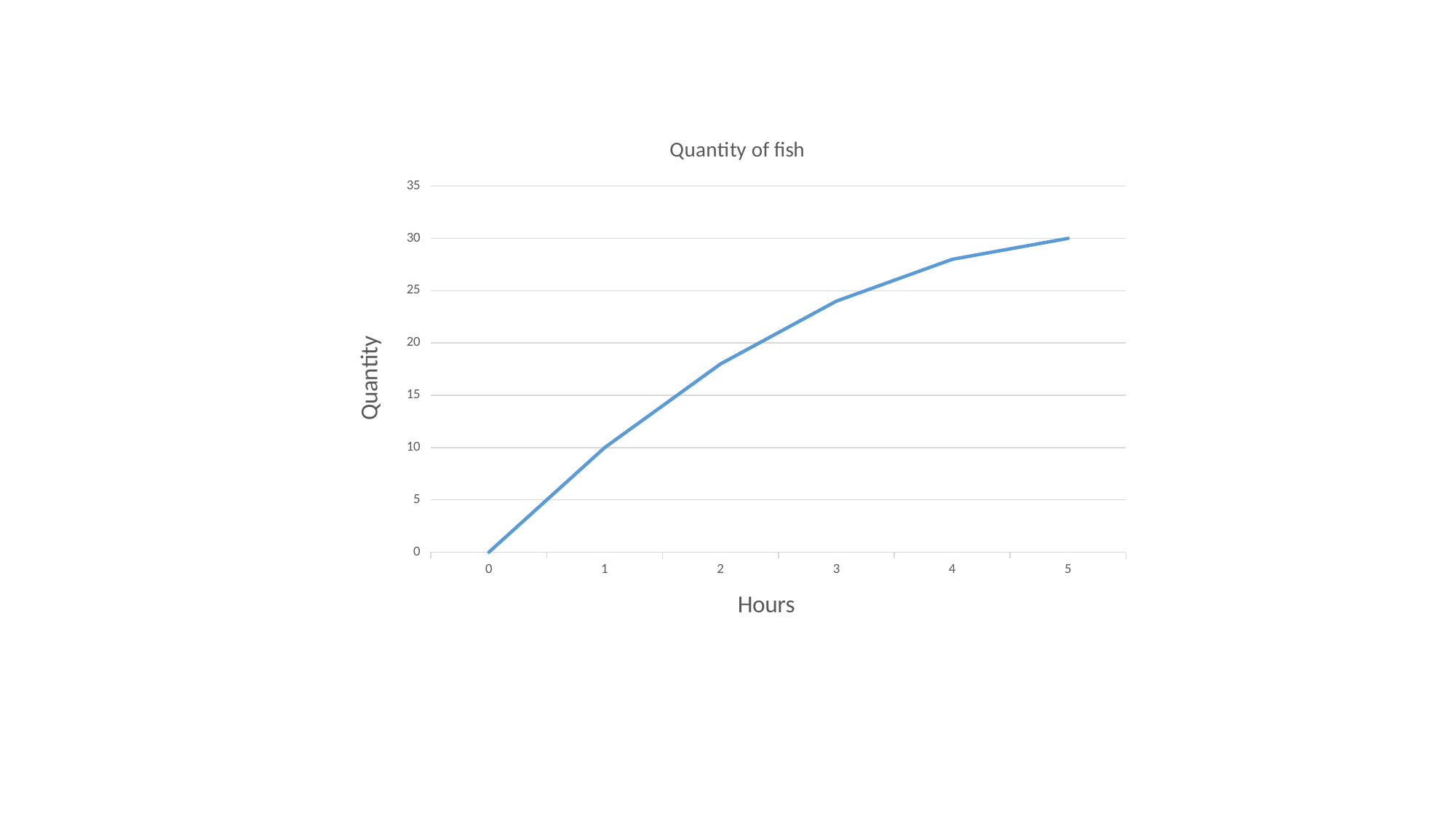
What kind of chart is shown on the slide? line chart At which hour is the quantity highest? 5 What is the quantity at 5 hours? 30 What is the label of the x axis? Hours What is the title of the chart? Quantity of fish What is the quantity at 0 hours? 0 At which hour is the quantity lowest? 0 Does the quantity rise or fall as hours increase? rise What is the difference between the quantity at 5 hours and the quantity at 1 hour? 20 Is the quantity at 2 hours greater or less than 15? greater How many data points are plotted on the line? 6 What is the quantity at 1 hour? 10